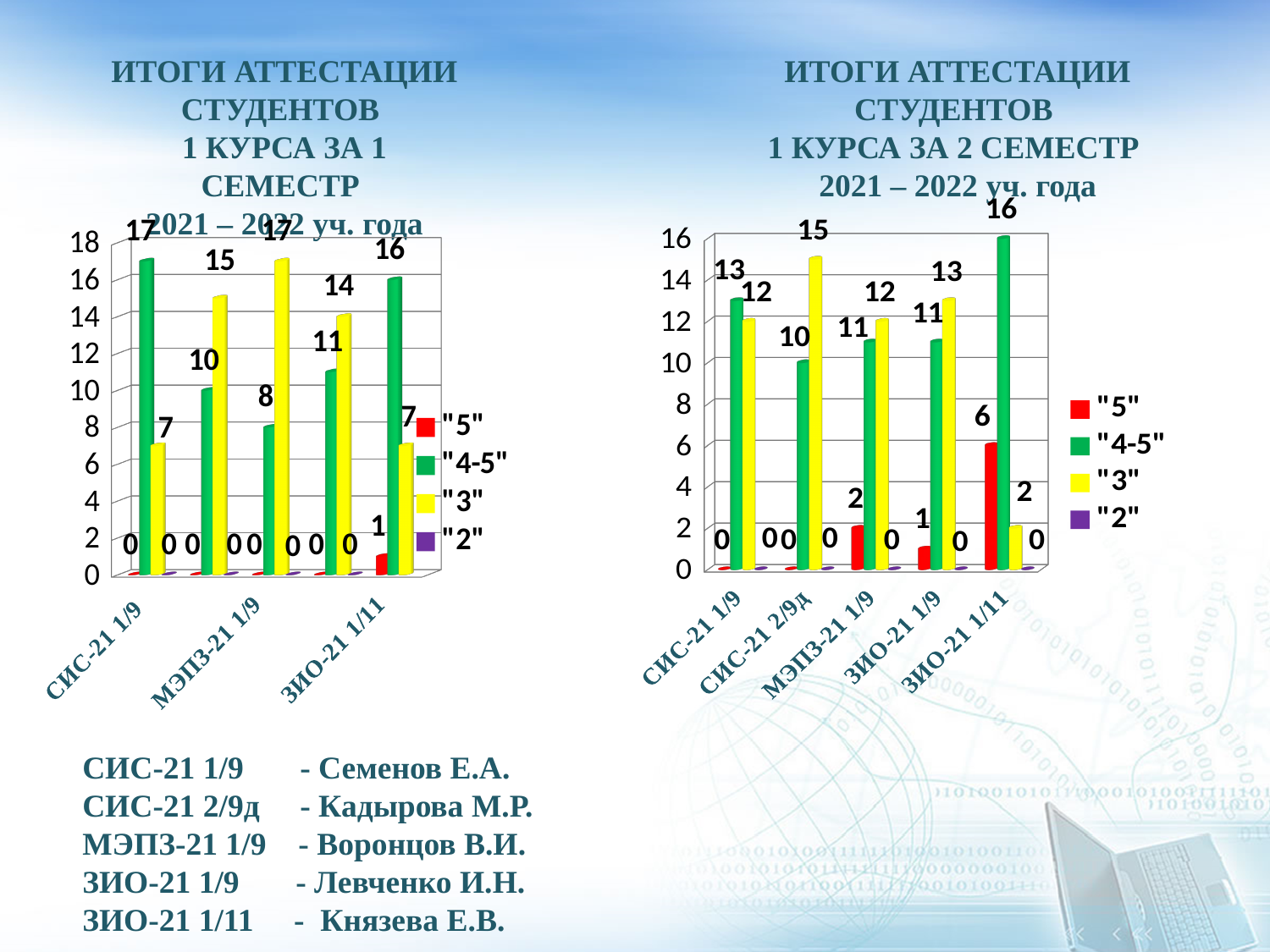
On the chart titled 'ИТОГИ АТТЕСТАЦИИ СТУДЕНТОВ 1 КУРСА ЗА 2 СЕМЕСТР', which group has the highest value for the "3" series? СИС-21 2/9д On the chart titled 'ИТОГИ АТТЕСТАЦИИ СТУДЕНТОВ 1 КУРСА ЗА 2 СЕМЕСТР', what is the value of the "5" series for ЗИО-21 1/11? 6 On the chart titled 'ИТОГИ АТТЕСТАЦИИ СТУДЕНТОВ 1 КУРСА ЗА 2 СЕМЕСТР', which group has the lowest value for the "3" series? ЗИО-21 1/11 What kind of chart is the one titled 'ИТОГИ АТТЕСТАЦИИ СТУДЕНТОВ 1 КУРСА ЗА 1 СЕМЕСТР'? bar chart On the chart titled 'ИТОГИ АТТЕСТАЦИИ СТУДЕНТОВ 1 КУРСА ЗА 2 СЕМЕСТР', how many series does the legend list? 4 On the chart titled 'ИТОГИ АТТЕСТАЦИИ СТУДЕНТОВ 1 КУРСА ЗА 2 СЕМЕСТР', what is the difference between the "4-5" value and the "3" value for ЗИО-21 1/11? 14 On the chart titled 'ИТОГИ АТТЕСТАЦИИ СТУДЕНТОВ 1 КУРСА ЗА 2 СЕМЕСТР', what is the value of the "3" series for ЗИО-21 1/9? 13 On the chart titled 'ИТОГИ АТТЕСТАЦИИ СТУДЕНТОВ 1 КУРСА ЗА 1 СЕМЕСТР', what is the value of the "4-5" series for СИС-21 1/9? 17 On the chart titled 'ИТОГИ АТТЕСТАЦИИ СТУДЕНТОВ 1 КУРСА ЗА 2 СЕМЕСТР', what is the value of the "4-5" series for ЗИО-21 1/11? 16 On the chart titled 'ИТОГИ АТТЕСТАЦИИ СТУДЕНТОВ 1 КУРСА ЗА 2 СЕМЕСТР', which group has the larger "4-5" value: СИС-21 1/9 or СИС-21 2/9д? СИС-21 1/9 On the chart titled 'ИТОГИ АТТЕСТАЦИИ СТУДЕНТОВ 1 КУРСА ЗА 2 СЕМЕСТР', how many groups are shown on the x axis? 5 On the chart titled 'ИТОГИ АТТЕСТАЦИИ СТУДЕНТОВ 1 КУРСА ЗА 1 СЕМЕСТР', what is the value of the "5" series for ЗИО-21 1/11? 1